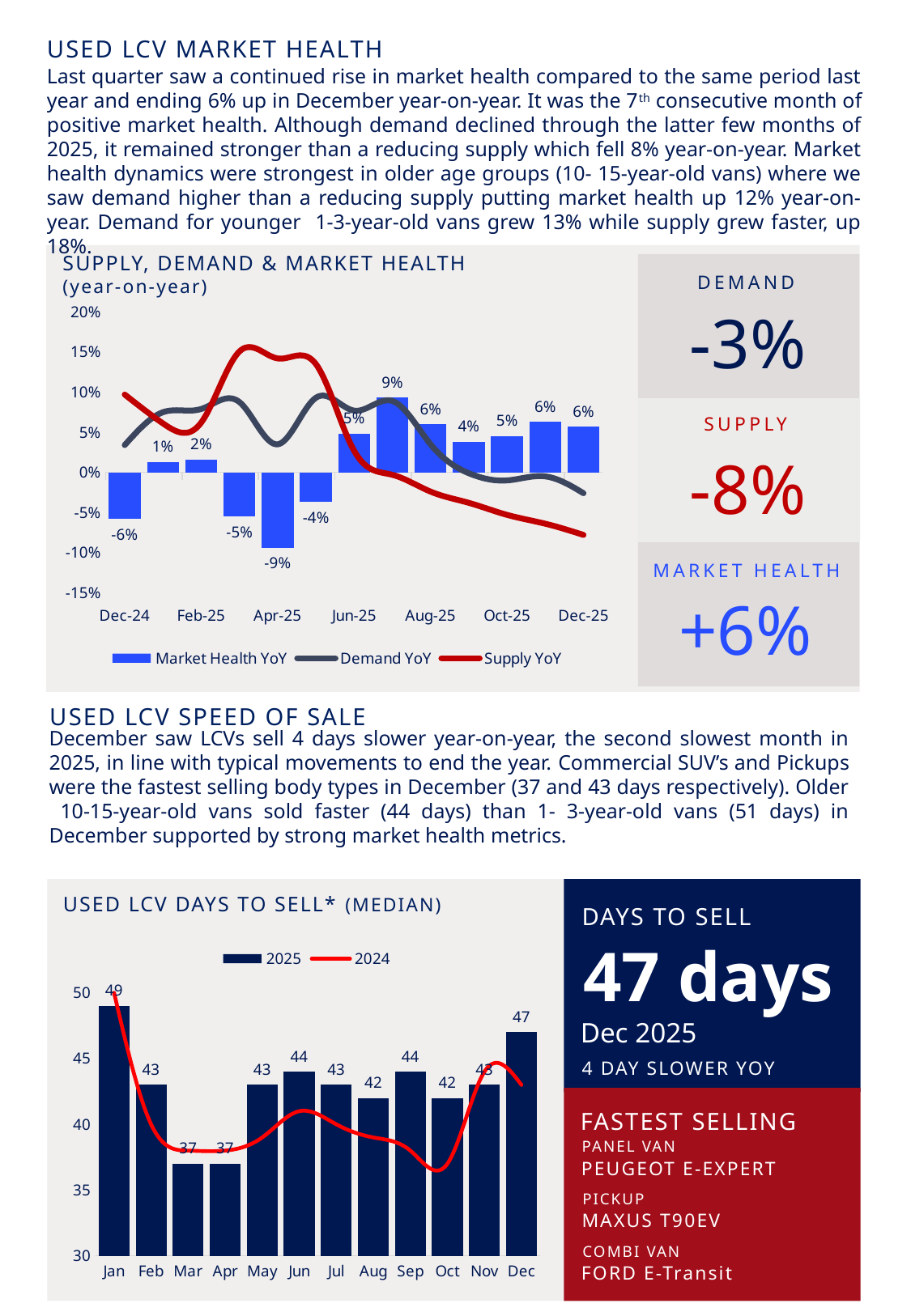
In the SUPPLY, DEMAND & MARKET HEALTH chart, what is the highest Market Health YoY value shown on a bar? 9% In the USED LCV DAYS TO SELL chart, which is larger, the 2025 value for Jun or for Aug? Jun In the SUPPLY, DEMAND & MARKET HEALTH chart, what is the difference between the Market Health YoY values for Dec-25 and Dec-24? 12 percentage points In the SUPPLY, DEMAND & MARKET HEALTH chart, what is the Market Health YoY value for Dec-25? 6% In the SUPPLY, DEMAND & MARKET HEALTH chart, what is the Market Health YoY value for Apr-25? -9% In the SUPPLY, DEMAND & MARKET HEALTH chart, which month has the lowest Market Health YoY bar? Apr-25 In the USED LCV DAYS TO SELL chart, what is the 2025 value for Dec? 47 In the USED LCV DAYS TO SELL chart, what is the difference between the 2025 values for Jan and Mar? 12 In the USED LCV DAYS TO SELL chart, which month has the highest 2025 bar? Jan In the SUPPLY, DEMAND & MARKET HEALTH chart, how many series does the legend list? 3 In the SUPPLY, DEMAND & MARKET HEALTH chart, is the Supply YoY line at Apr-25 greater or less than 10%? greater In the USED LCV DAYS TO SELL chart, how many months are shown on the x axis? 12